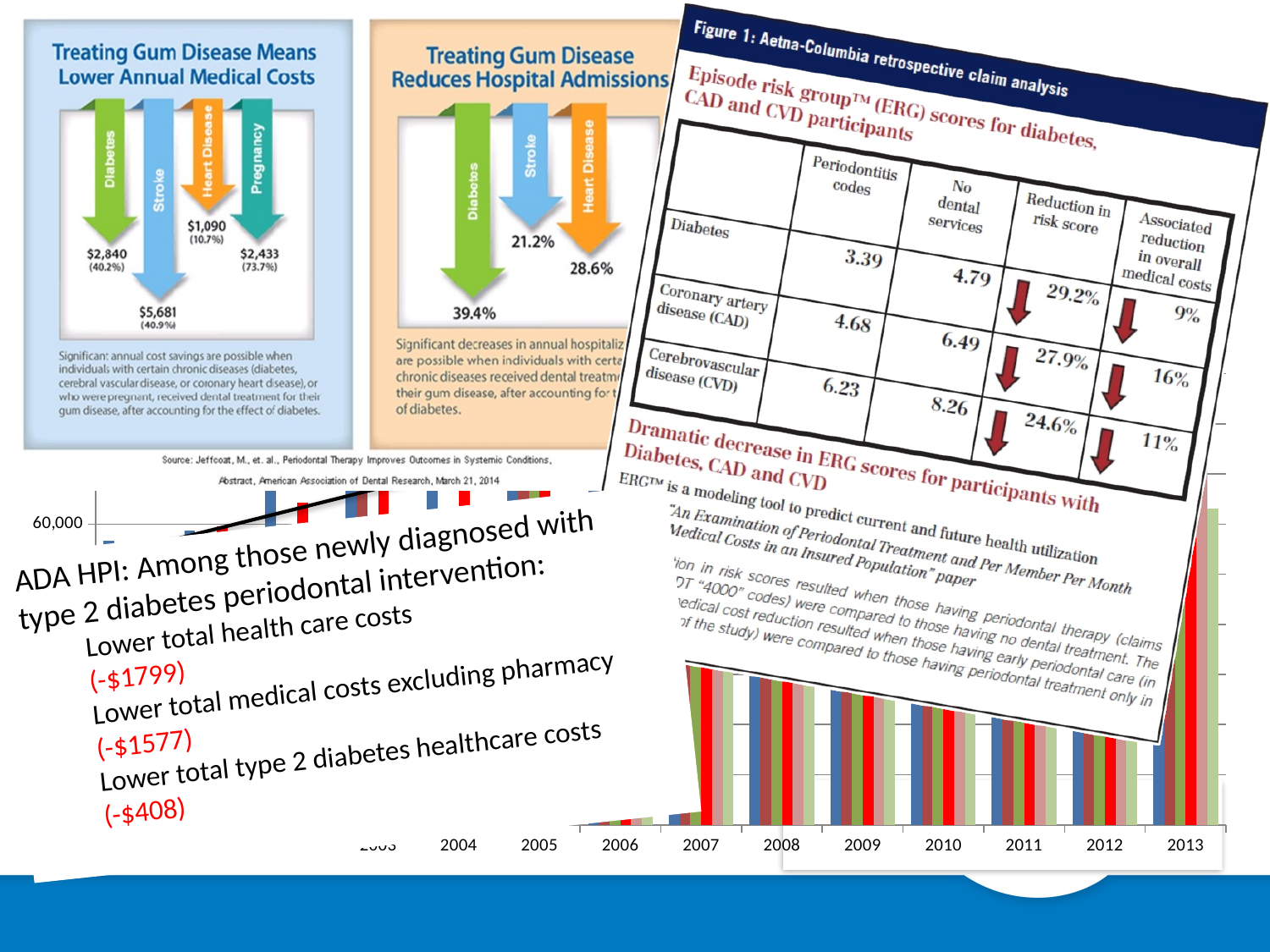
In the 'Treating Gum Disease Means Lower Annual Medical Costs' graphic, what is the dollar amount shown for Stroke? $5,681 In the 'Treating Gum Disease Reduces Hospital Admissions' graphic, what percentage is shown for Diabetes? 39.4% In the background bar chart with years on the x axis, do the bar heights generally rise or fall from 2004 to 2013? rise In the 'Treating Gum Disease Means Lower Annual Medical Costs' graphic, which condition has the smallest dollar amount? Heart Disease In the 'Treating Gum Disease Means Lower Annual Medical Costs' graphic, what is the dollar amount shown for Diabetes? $2,840 In the 'Treating Gum Disease Means Lower Annual Medical Costs' graphic, what percentage is shown for Pregnancy? 73.7% In the background bar chart with years on the x axis, which year has taller bars, 2008 or 2013? 2013 In the 'Treating Gum Disease Reduces Hospital Admissions' graphic, which condition has the highest percentage? Diabetes What kind of chart is the large chart in the background with years along the x axis? bar chart